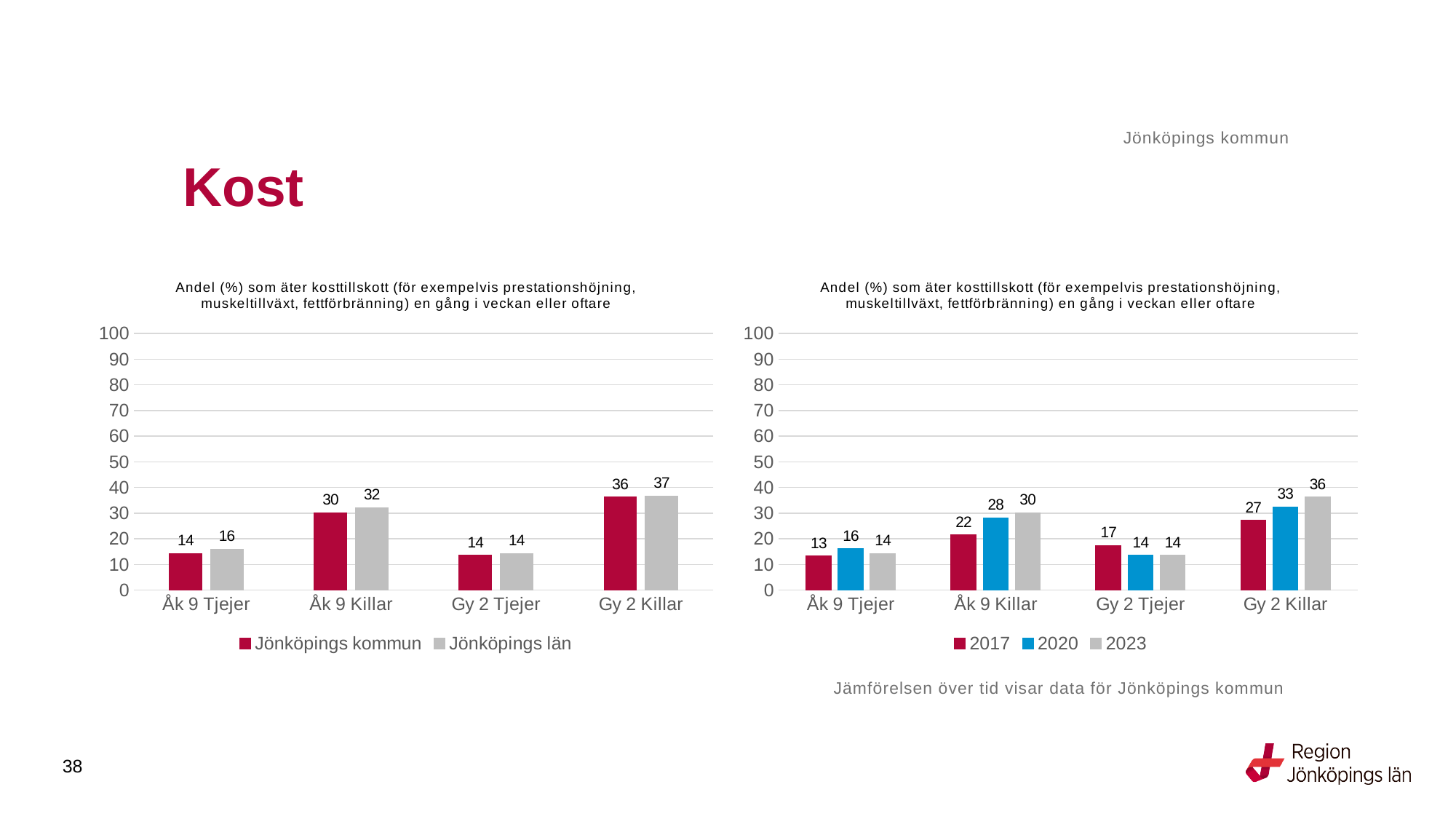
In the right chart, which year has the lowest value for Gy 2 Killar? 2017 In the right chart, what is the value for 2020 for Åk 9 Killar? 28 In the right chart, is the 2023 value for Gy 2 Killar larger than the 2017 value for Gy 2 Killar? Yes In the left chart, how many series does the legend list? 2 In the right chart, how many categories are shown on the x axis? 4 In the right chart, what is the value for 2017 for Gy 2 Tjejer? 17 In the left chart, what is the value for Jönköpings län for Gy 2 Killar? 37 In the right chart, what is the difference between the 2023 and 2017 values for Gy 2 Killar? 9 In the left chart, what is the value for Jönköpings kommun for Åk 9 Killar? 30 In the left chart, which category has the highest value for Jönköpings kommun? Gy 2 Killar In the left chart, what is the difference between Jönköpings län and Jönköpings kommun for Åk 9 Tjejer? 2 What type of chart is the right chart? Bar chart